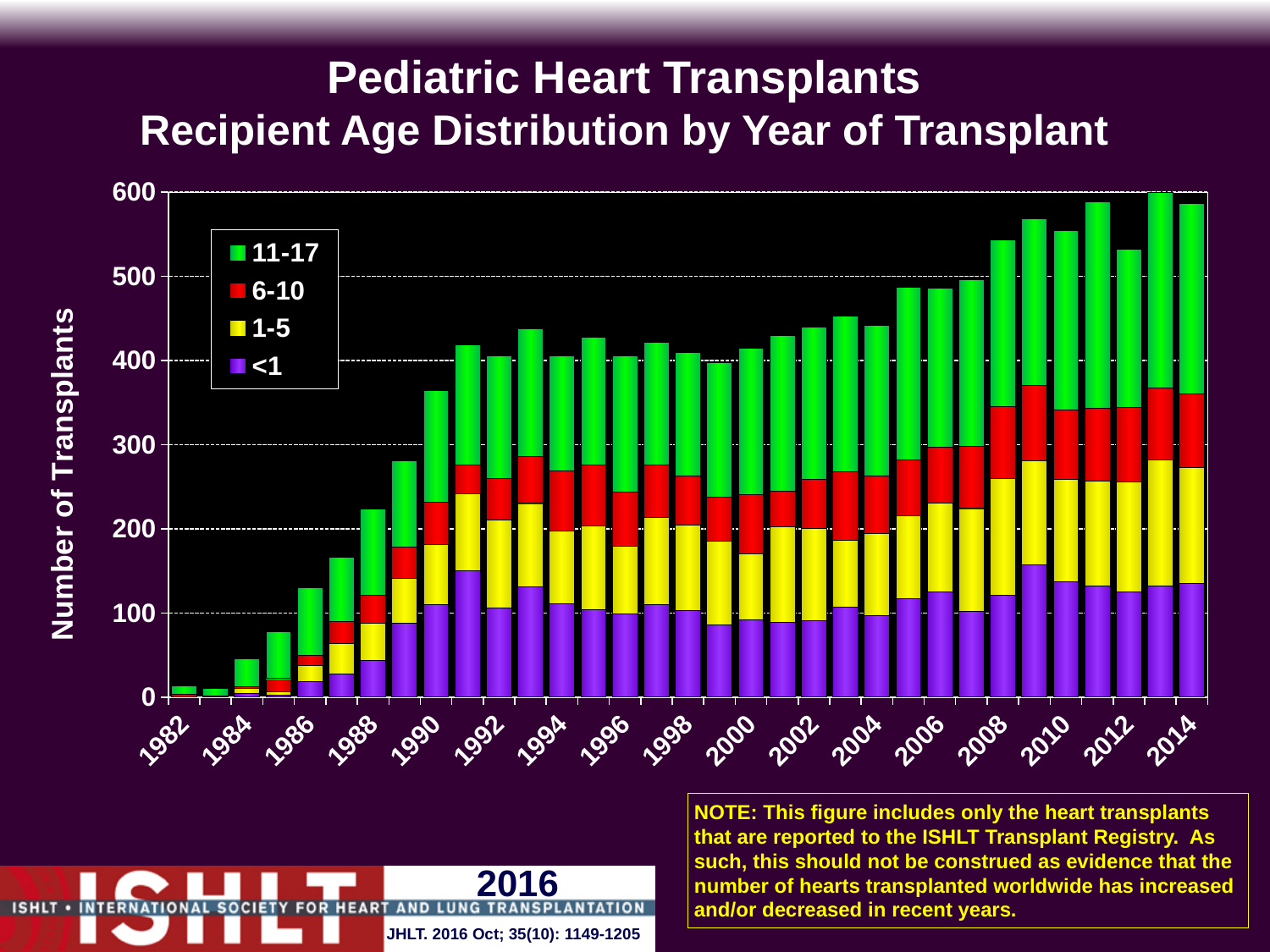
Which age groups are listed in the legend? 11-17, 6-10, 1-5, <1 Is the total number of transplants for 2009 greater or less than 500? greater Which year has the larger total number of transplants, 1985 or 1989? 1989 Is the total number of transplants for 1988 greater or less than 300? less What kind of chart is shown on the slide? Stacked bar chart Is the total number of transplants for 1986 greater or less than 100? greater What is the label on the vertical axis? Number of Transplants Do the total number of transplants rise or fall from 1982 to 1991? rise How many series does the legend list? 4 How many years (bars) are plotted, from 1982 to 2014? 33 Which year has the larger total number of transplants, 2000 or 2008? 2008